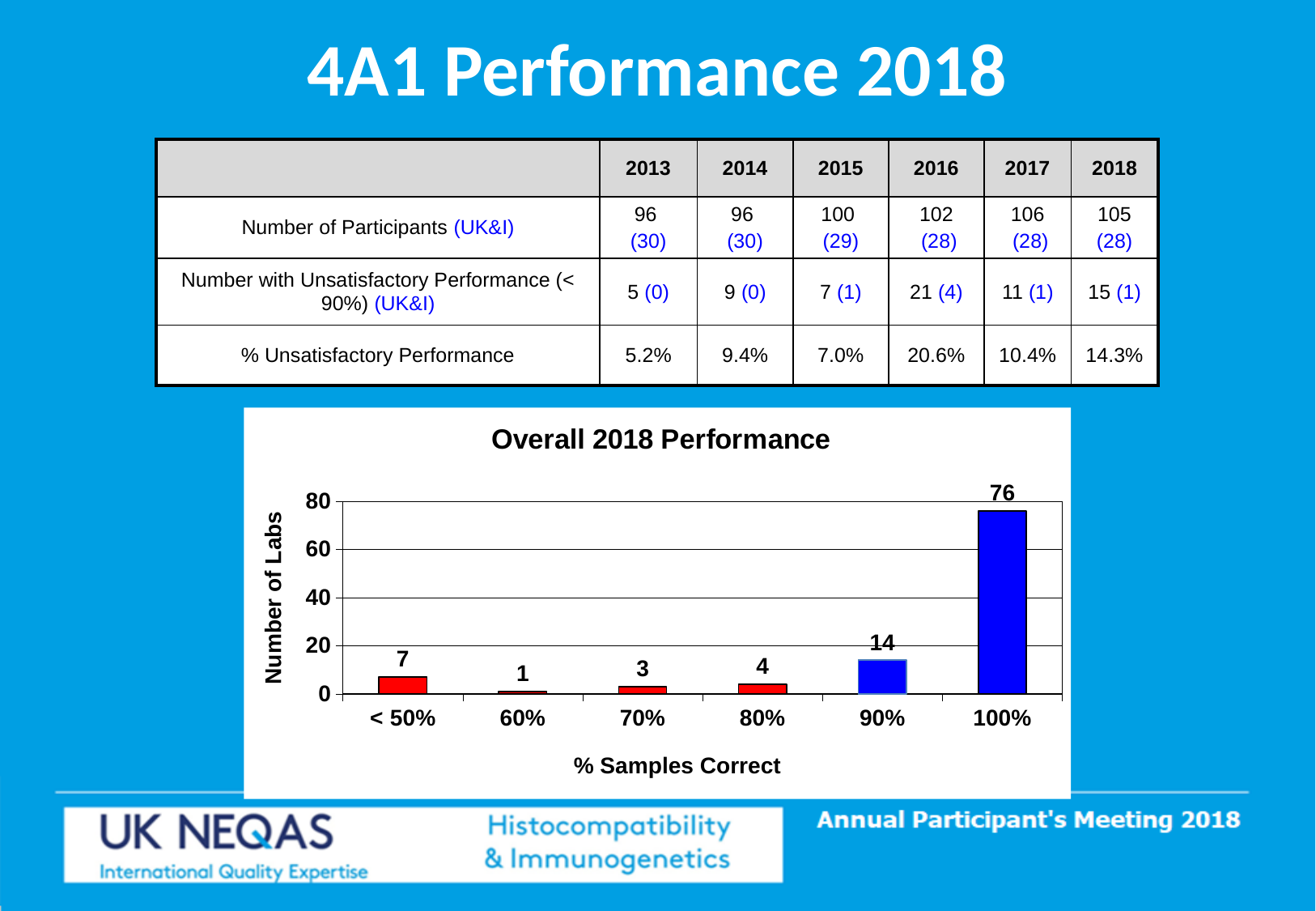
What is the x-axis label of the Overall 2018 Performance chart? % Samples Correct Which category has the highest number of labs in the Overall 2018 Performance chart? 100% What is the y-axis label of the Overall 2018 Performance chart? Number of Labs What is the number of labs for the 100% category in the Overall 2018 Performance chart? 76 What is the number of labs for the 90% category in the Overall 2018 Performance chart? 14 Which has more labs in the Overall 2018 Performance chart, the 70% category or the 80% category? 80% What kind of chart is the Overall 2018 Performance chart? Bar chart Which category has the lowest number of labs in the Overall 2018 Performance chart? 60% Is the value for the 100% category in the Overall 2018 Performance chart greater or less than 60? greater What is the difference in number of labs between the 100% and 90% categories in the Overall 2018 Performance chart? 62 How many categories are shown on the x axis of the Overall 2018 Performance chart? 6 What is the number of labs for the < 50% category in the Overall 2018 Performance chart? 7